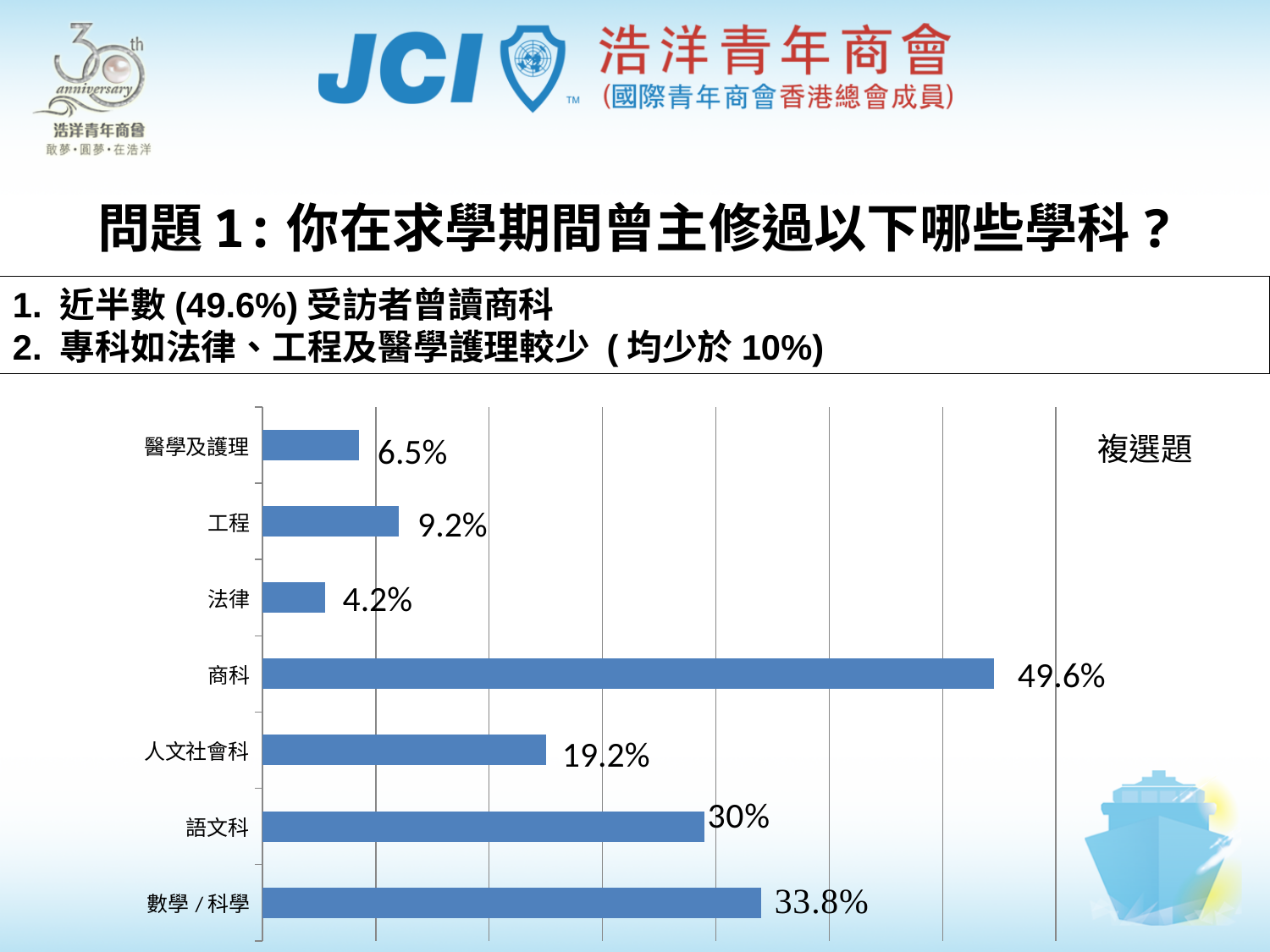
What kind of chart is shown on the slide? Bar chart Which is larger, the value for 語文科 or the value for 人文社會科? 語文科 What is the value shown for 數學 / 科學? 33.8% What is the difference between the values for 商科 and 數學 / 科學? 15.8% What is the value shown for 語文科? 30% Which subject has the highest percentage? 商科 How many subject categories are shown in the chart? 7 What is the difference between the values for 工程 and 醫學及護理? 2.7% What note is written in the top-right corner of the chart area? 複選題 What is the value shown for 法律? 4.2% What percentage of respondents majored in 商科? 49.6% Which subject has the lowest percentage? 法律